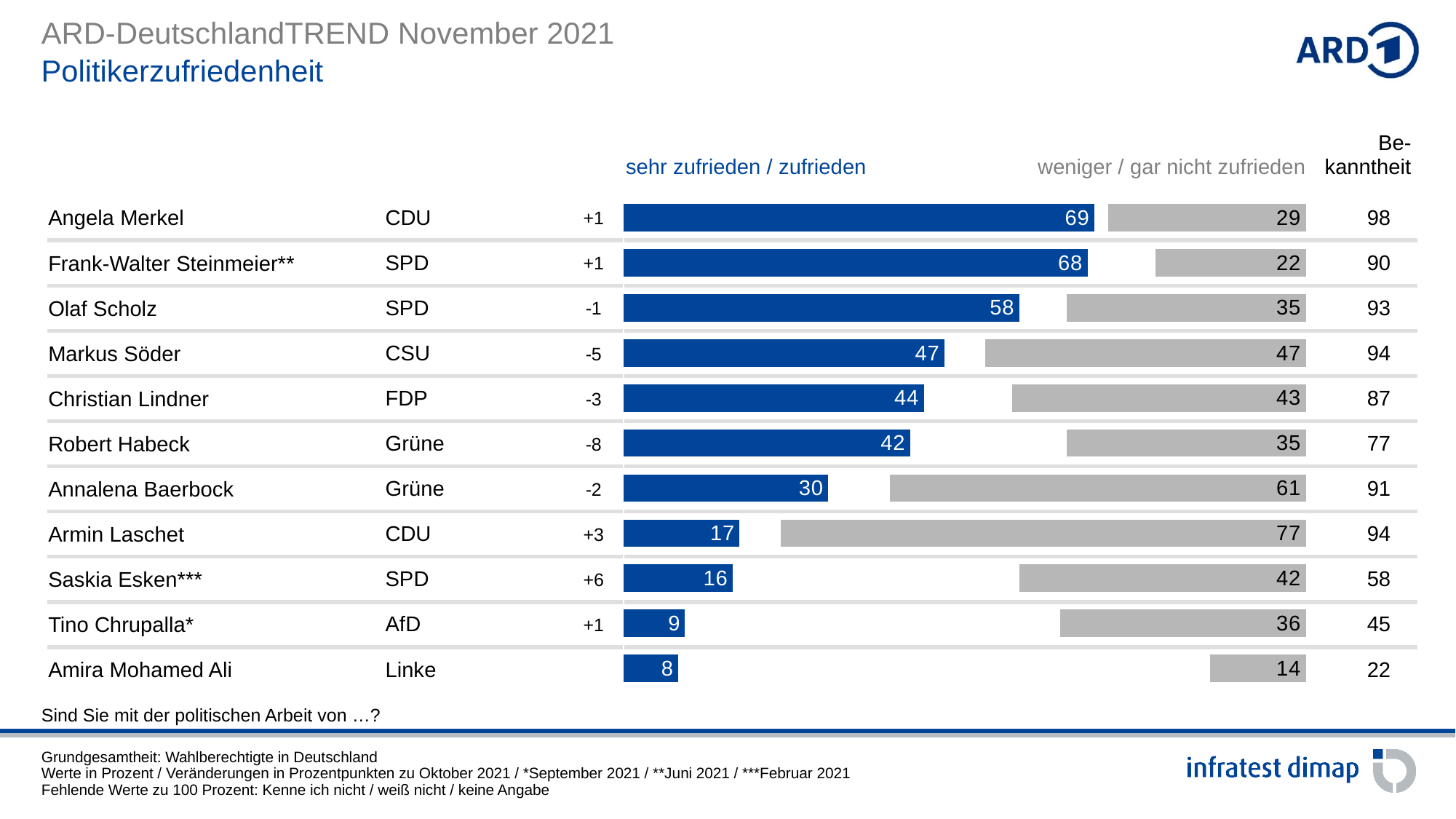
What is the 'sehr zufrieden / zufrieden' value for Angela Merkel? 69 How many politicians are shown in the chart? 11 What colour are the 'sehr zufrieden / zufrieden' bars? Blue Which politician has the highest 'sehr zufrieden / zufrieden' value? Angela Merkel Who has a larger 'sehr zufrieden / zufrieden' value, Christian Lindner or Robert Habeck? Christian Lindner Which politician has the highest 'weniger / gar nicht zufrieden' value? Armin Laschet What is the change in percentage points shown for Saskia Esken? +6 What type of chart is shown on the slide? Bar chart What is the 'weniger / gar nicht zufrieden' value for Annalena Baerbock? 61 What is the 'Bekanntheit' value for Robert Habeck? 77 What is the difference between the 'sehr zufrieden / zufrieden' values of Olaf Scholz and Markus Söder? 11 Which politician has the lowest 'sehr zufrieden / zufrieden' value? Amira Mohamed Ali